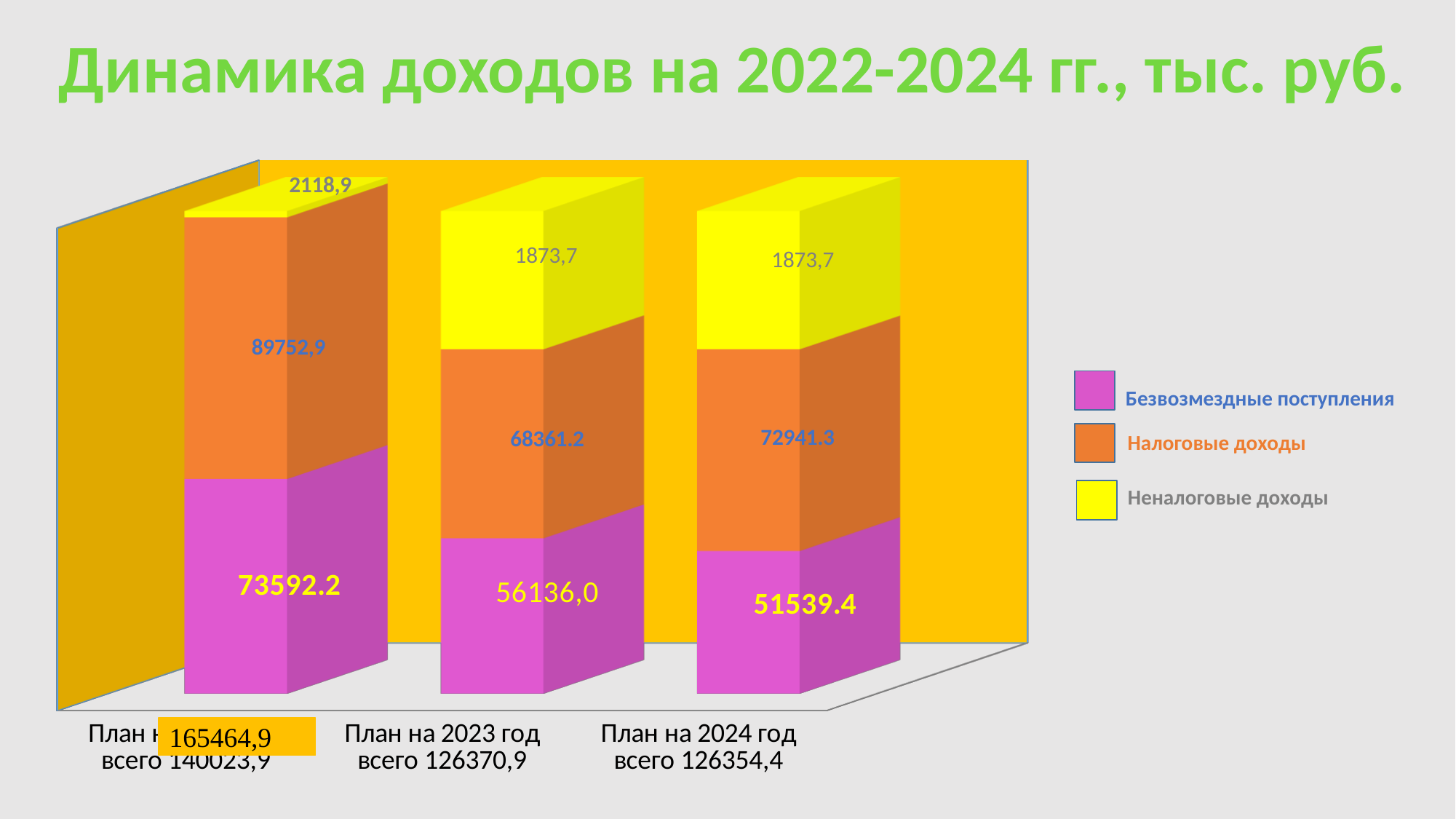
In which bar is Налоговые доходы the highest? the leftmost bar What is the value of Безвозмездные поступления for План на 2024 год? 51539.4 What is the total of the stacked bar for План на 2024 год? 126354,4 How many series does the legend list? 3 What is the value of Налоговые доходы for План на 2023 год? 68361.2 How many bars (categories) are plotted in the chart? 3 What is the difference in Налоговые доходы between План на 2024 год and План на 2023 год? 4580.1 Which is larger: Безвозмездные поступления for План на 2023 год or for План на 2024 год? План на 2023 год What type of chart is shown on the slide? stacked bar chart What is the value of Неналоговые доходы in the leftmost bar? 2118,9 What is the value of Налоговые доходы in the leftmost bar? 89752,9 In which category is Безвозмездные поступления the lowest? План на 2024 год